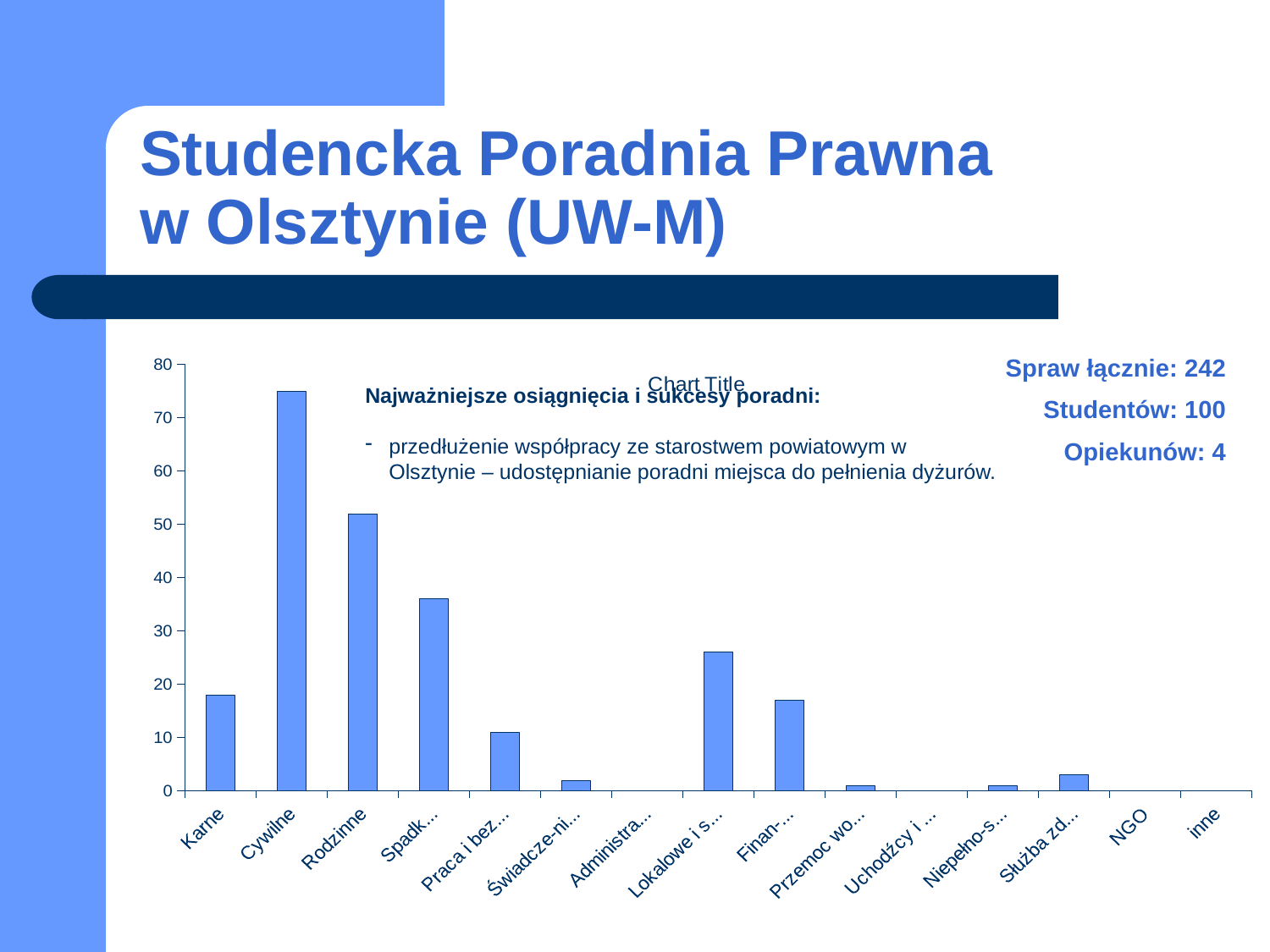
Is the value for Rodzinne greater or less than 50? greater Is the value for Cywilne greater or less than 70? greater Is the value for Karne greater or less than 20? less Which category has the highest bar in the chart? Cywilne What is the highest value shown on the vertical axis of the chart? 80 Which is larger, the value for Rodzinne or the value for Spadk...? Rodzinne Which is larger, the value for Lokalowe i s... or the value for Karne? Lokalowe i s... How many categories are shown along the x axis of the chart? 15 What kind of chart is shown on the slide? bar chart What text is shown as the title of the chart? Chart Title